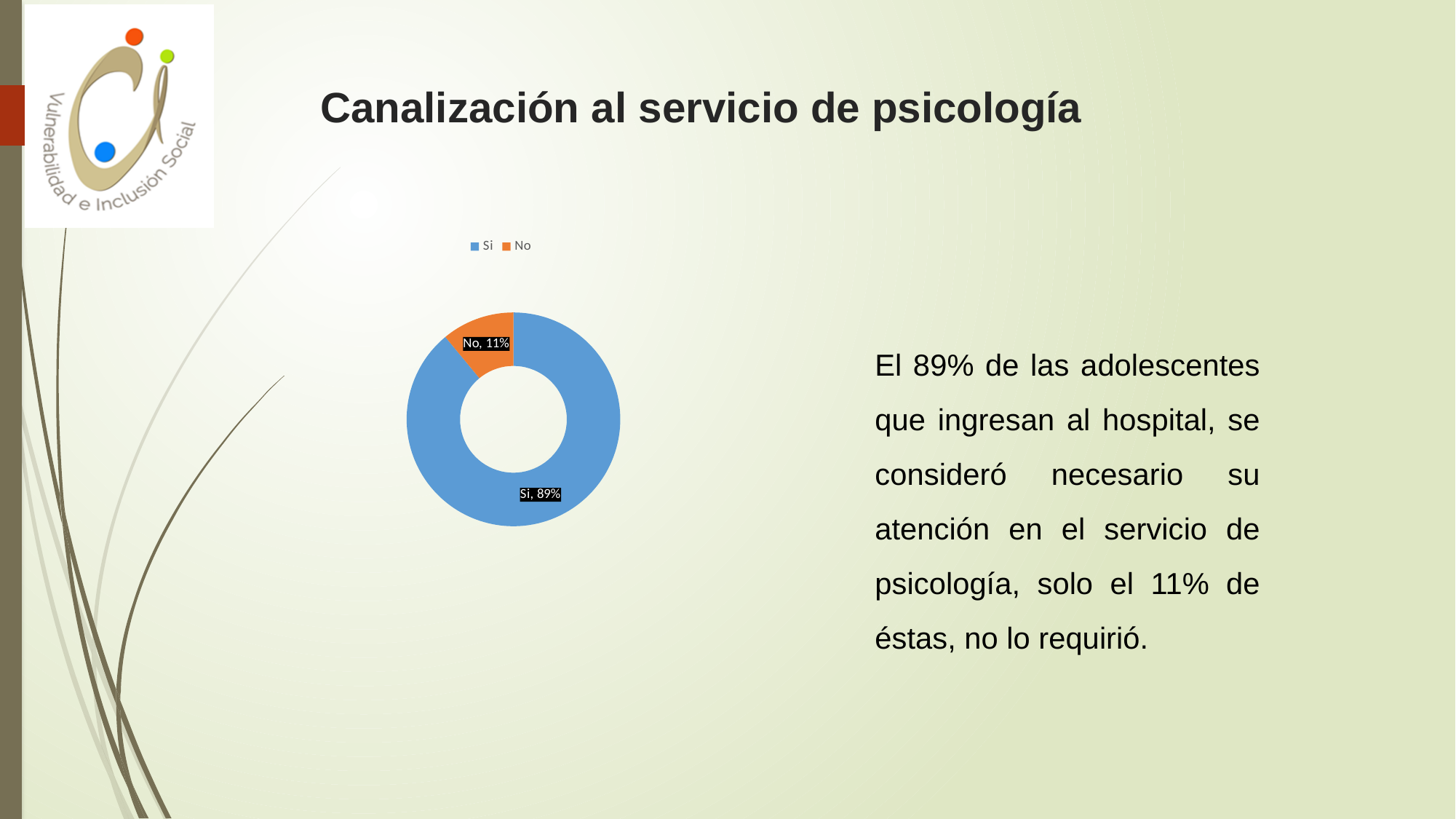
What percentage does the 'Si' slice represent? 89% What share of the chart does the 'No' slice take up? 11% What is the difference in percentage points between the 'Si' and 'No' slices? 78 What percentage does the 'No' slice represent? 11% What is the title of the slide containing the chart? Canalización al servicio de psicología What kind of chart is shown on the slide? Doughnut (pie) chart How many entries does the legend list? 2 Which is larger, the 'Si' slice or the 'No' slice? Si Which category has the largest share of the chart? Si Which category has the smallest share of the chart? No How many categories are shown in the chart? 2 What colour is the 'Si' slice? Blue